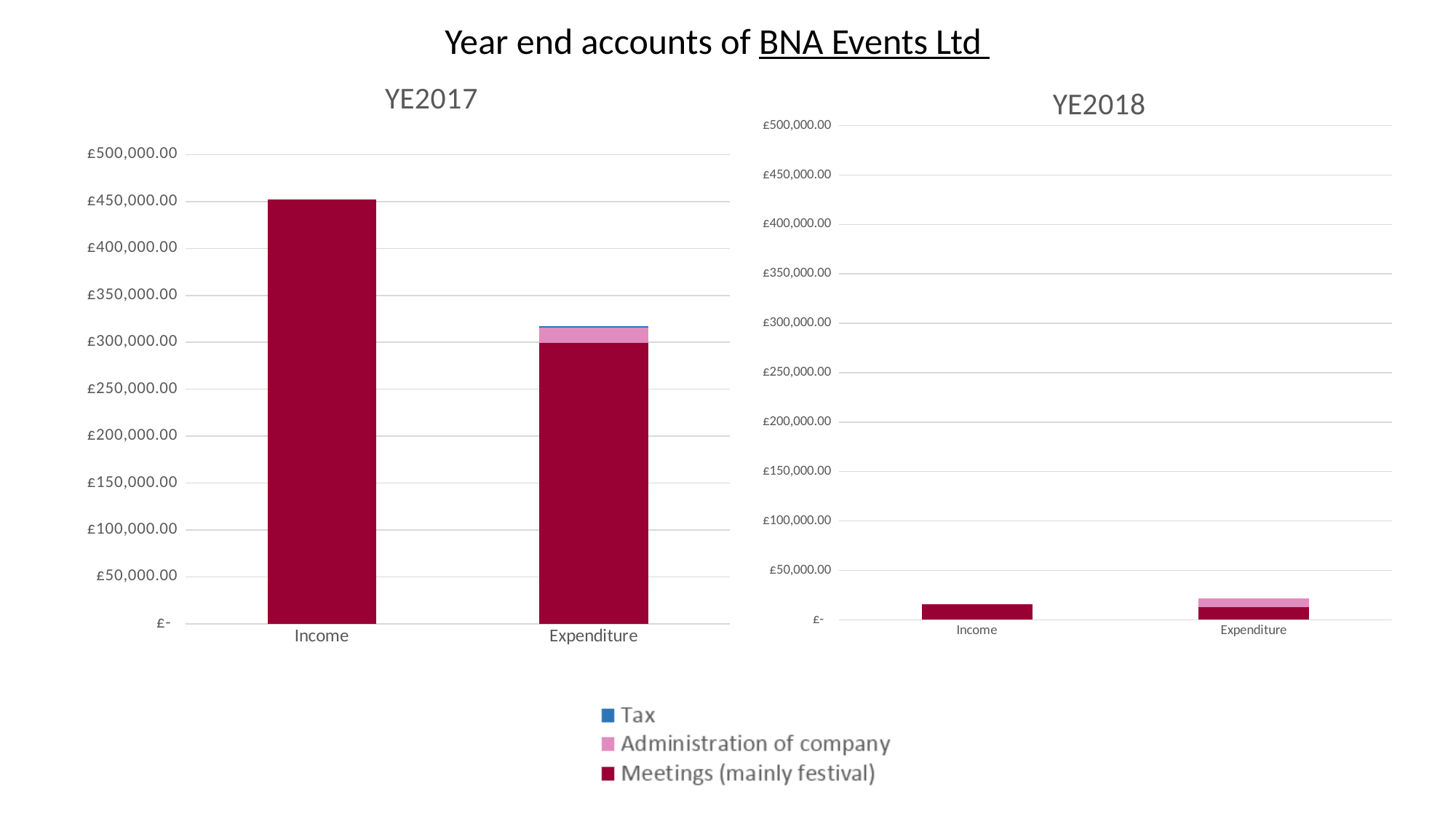
In the YE2018 chart, is the value for Income greater or less than £50,000.00? less What kind of chart is the YE2017 chart? bar chart In the YE2017 chart, is the value for Income greater or less than £400,000.00? greater How many series does the legend list? 3 In the YE2017 chart, which category has the highest bar? Income Which series is shown in pink in the legend? Administration of company What is the title of the chart on the right of the slide? YE2018 In the YE2017 chart, is the total for Expenditure greater or less than £350,000.00? less In the YE2018 chart, which category has the taller bar, Income or Expenditure? Expenditure In the YE2017 chart, which category has the taller bar, Income or Expenditure? Income How many categories are shown on the x axis of the YE2018 chart? 2